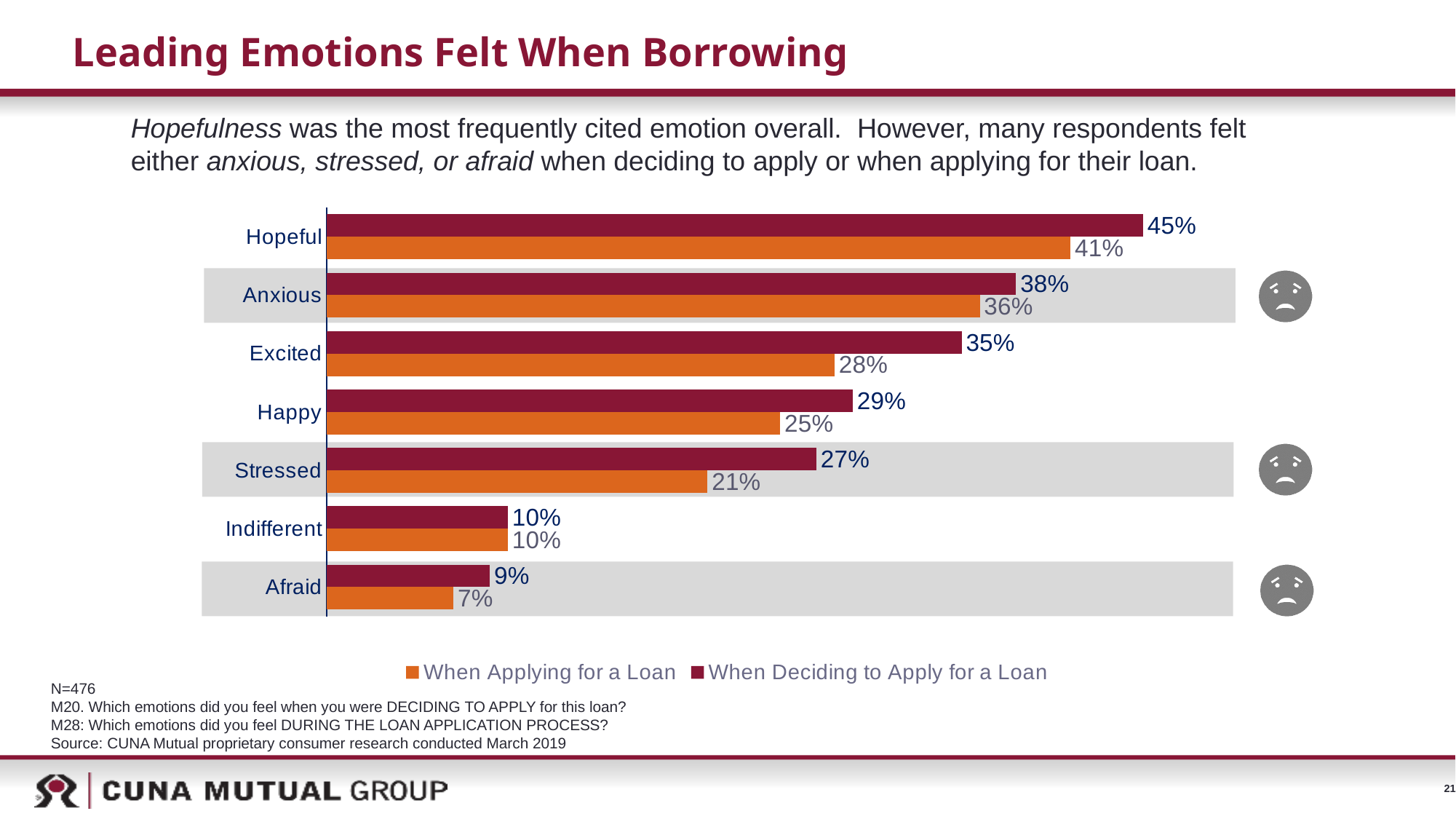
What is the difference between the 'When Deciding to Apply for a Loan' and 'When Applying for a Loan' values for Excited? 7% How many emotions are listed on the chart? 7 What percentage of respondents felt Stressed when applying for a loan? 21% Which emotion has the lowest value for the 'When Applying for a Loan' series? Afraid What percentage of respondents felt Hopeful when deciding to apply for a loan? 45% How many series does the legend list? 2 Which is larger for Anxious: the value when deciding to apply or the value when applying for a loan? When Deciding to Apply for a Loan What percentage of respondents felt Excited when applying for a loan? 28% What kind of chart is shown on the slide? Bar chart What is the value for Indifferent when applying for a loan? 10% Which emotion has the highest value for the 'When Deciding to Apply for a Loan' series? Hopeful Which colour represents the 'When Applying for a Loan' series? Orange